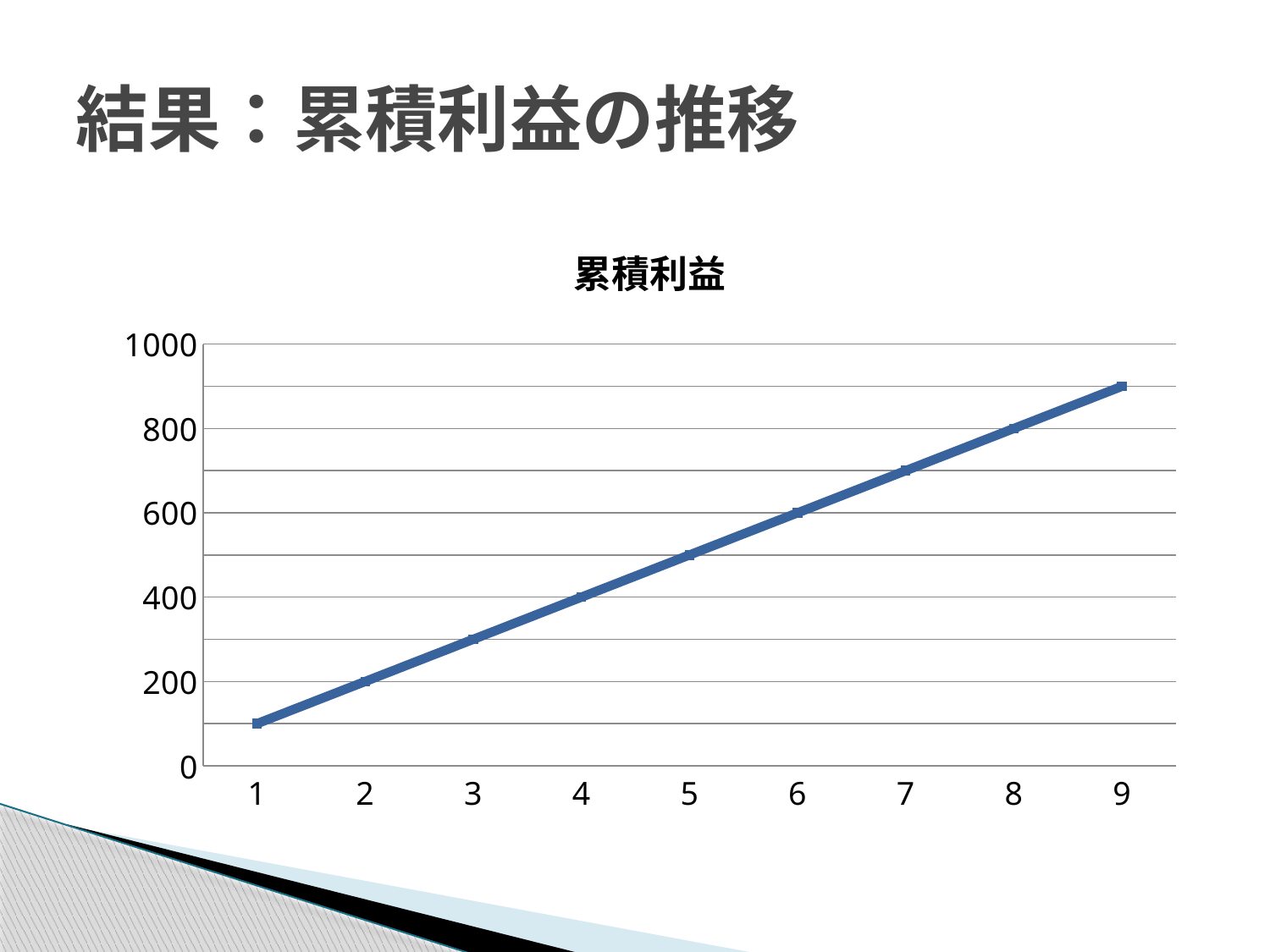
Is the value at x = 9 greater or less than 800? greater Is the value at x = 1 greater or less than 200? less What is the value at x = 8? 800 How many data points are plotted on the line? 9 Do the values rise or fall as x increases from 1 to 9? rise What is the title of the chart? 累積利益 At which x value is the line lowest? 1 What is the value at x = 4? 400 What is the value at x = 6? 600 What kind of chart is shown on the slide? line chart At which x value is the line highest? 9 What is the value at x = 2? 200